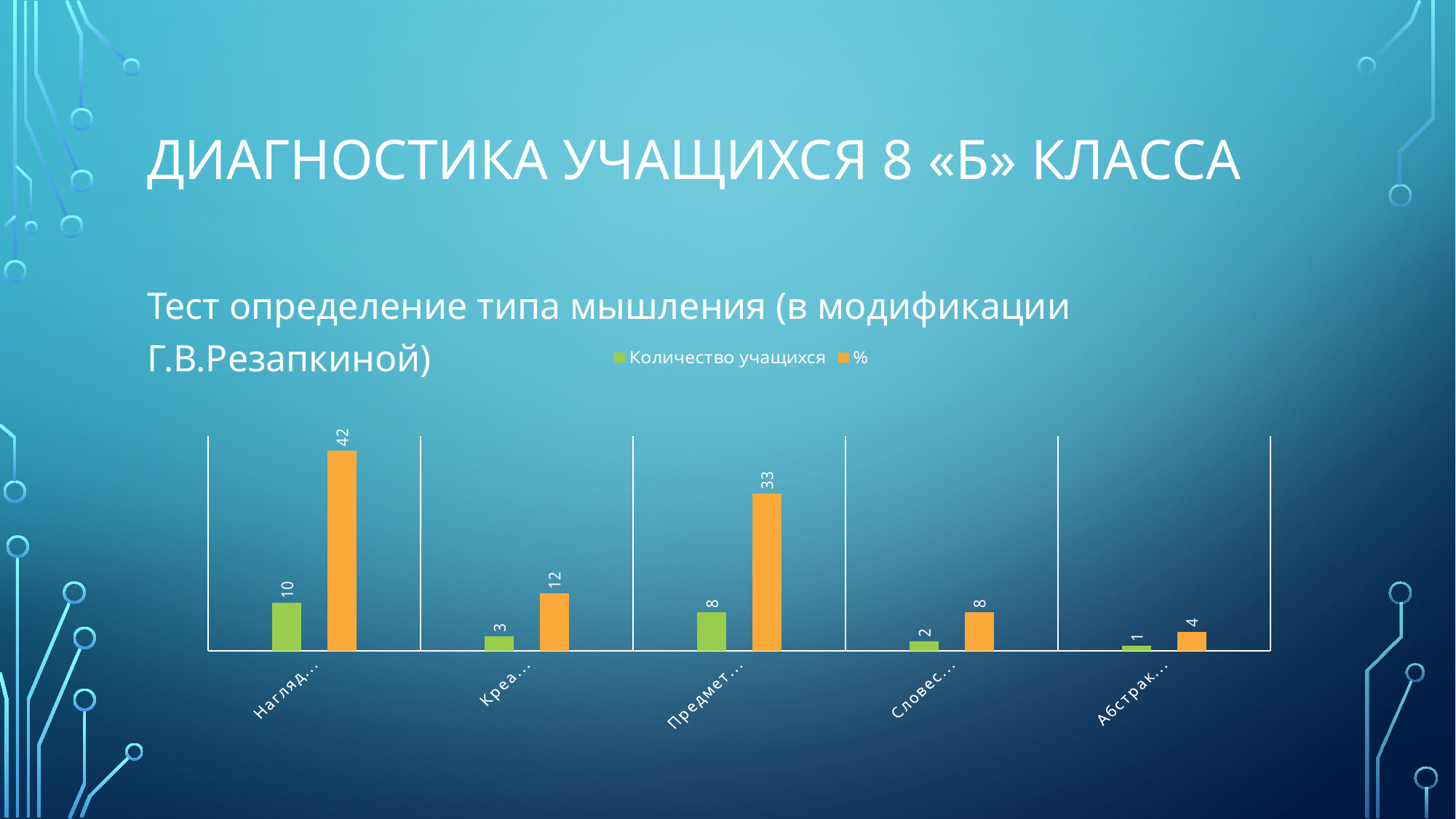
What is the value of the "Количество учащихся" series for the first category ("Нагляд...")? 10 Which category has the lowest value in the "Количество учащихся" series? Абстрак... (the last category) What is the value of the "%" series for the third category ("Предмет...")? 33 What is the value of the "Количество учащихся" series for the last category ("Абстрак...")? 1 What is the difference between the "%" values for the first category ("Нагляд...") and the third category ("Предмет...")? 9 How many categories are shown on the x axis? 5 Which category has the highest value in the "%" series? Нагляд... (the first category) What kind of chart is shown on the slide? bar chart Which is larger: the "Количество учащихся" value for "Креа..." or for "Словес..."? Креа... What is the value of the "%" series for the first category ("Нагляд...")? 42 How many series does the legend list? 2 What are the two legend entries of the chart? Количество учащихся and %